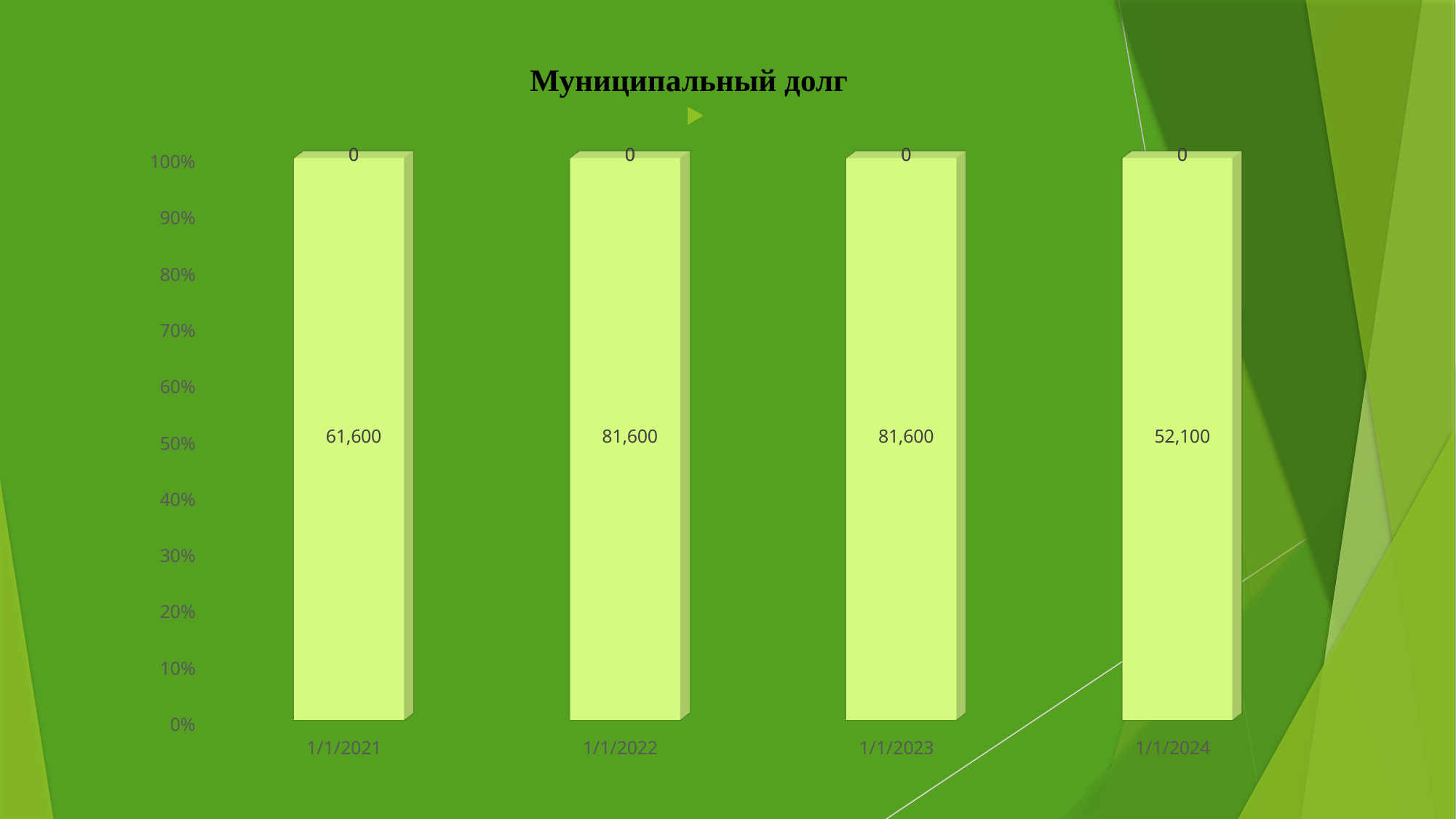
What is the difference between the labelled values for 1/1/2023 and 1/1/2024? 29,500 What value is labelled on the bar for 1/1/2024? 52,100 What is the title of the chart? Муниципальный долг What is the difference between the labelled values for 1/1/2022 and 1/1/2021? 20,000 Which category has the lowest labelled value? 1/1/2024 What is the label of the first category on the x axis? 1/1/2021 Do the labelled values for 1/1/2022 and 1/1/2023 differ? No, both are 81,600 Which is larger, the labelled value for 1/1/2021 or for 1/1/2024? 1/1/2021 What value is labelled on the bar for 1/1/2022? 81,600 What value is labelled on the bar for 1/1/2021? 61,600 How many categories are shown on the x axis of the chart? 4 What kind of chart is shown on the slide? bar chart